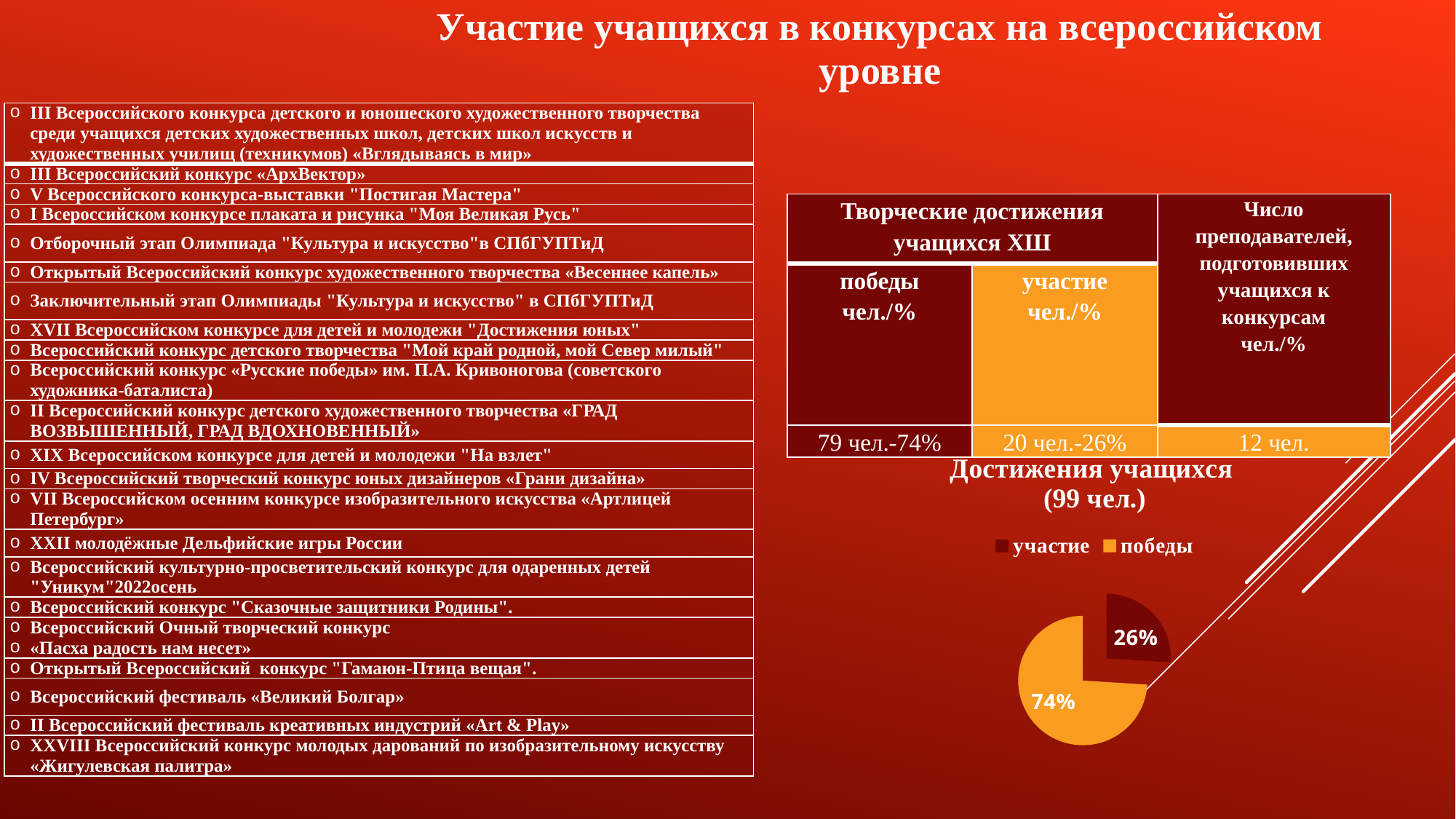
What is the title of the pie chart on the slide? Достижения учащихся (99 чел.) In the pie chart "Достижения учащихся (99 чел.)", what colour is the "победы" slice? orange In the pie chart "Достижения учащихся (99 чел.)", what is the difference in percentage points between "победы" and "участие"? 48 How many slices does the pie chart "Достижения учащихся (99 чел.)" have? 2 How many entries does the legend of the pie chart "Достижения учащихся (99 чел.)" list? 2 In the pie chart "Достижения учащихся (99 чел.)", is the share for "победы" greater or less than 50%? greater In the pie chart "Достижения учащихся (99 чел.)", what share is labelled for "участие"? 26% In the pie chart "Достижения учащихся (99 чел.)", which slice is the largest? победы In the pie chart "Достижения учащихся (99 чел.)", what share is labelled for "победы"? 74% In the pie chart "Достижения учащихся (99 чел.)", which is larger: "участие" or "победы"? победы In the pie chart "Достижения учащихся (99 чел.)", which slice is the smallest? участие What kind of chart is shown under the title "Достижения учащихся (99 чел.)"? pie chart